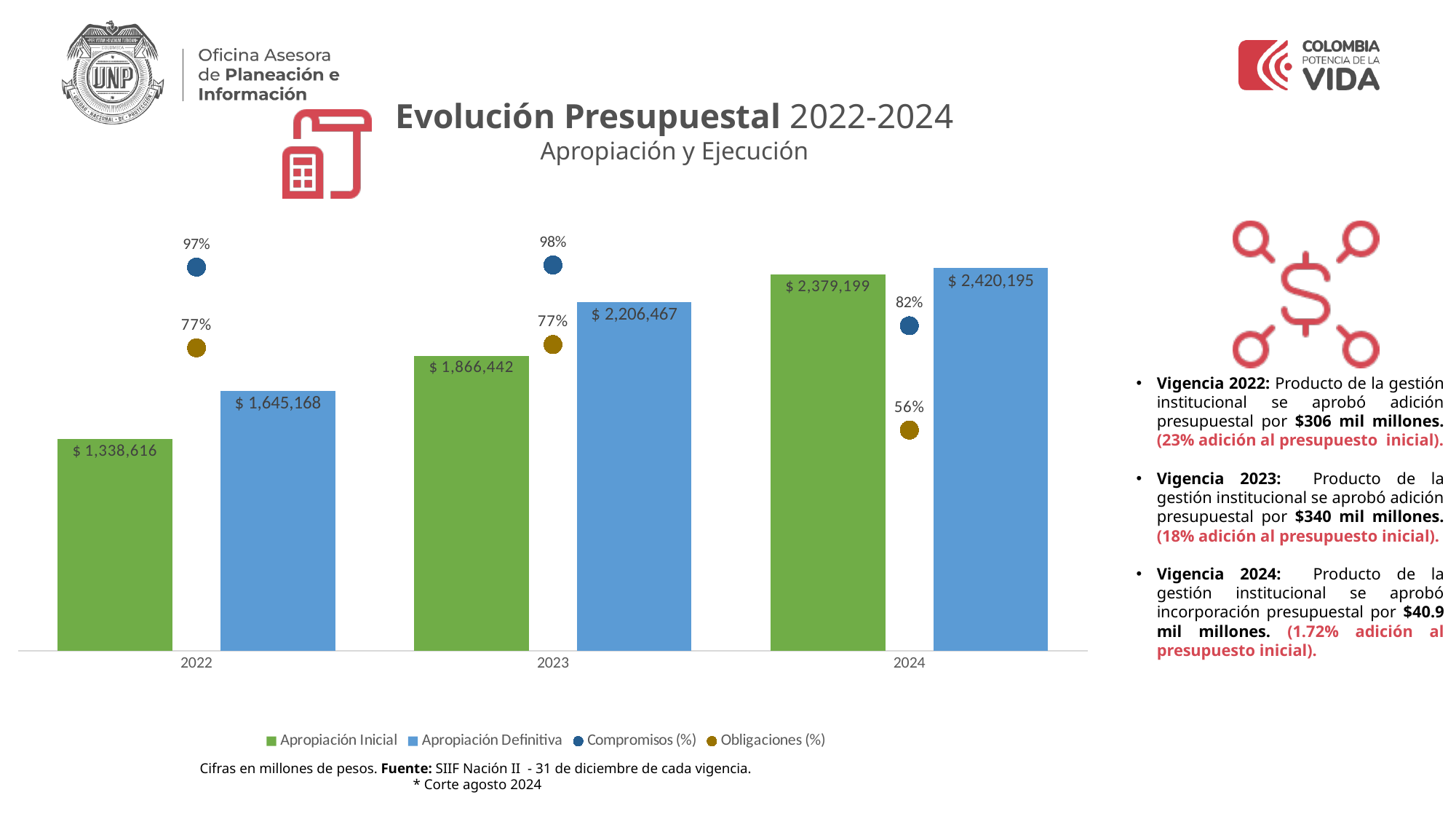
How many years are shown on the x axis of the chart? 3 Which year has the lowest Obligaciones (%)? 2024 Does the Apropiación Inicial rise or fall from 2022 to 2024? rise What is the difference between Apropiación Definitiva and Apropiación Inicial in 2023? $ 340,025 How many series does the chart legend list? 4 What is the Apropiación Inicial value for 2022? $ 1,338,616 Which year has the highest Apropiación Definitiva? 2024 Which is larger in 2024: Apropiación Inicial or Apropiación Definitiva? Apropiación Definitiva What is the Compromisos (%) value for 2024? 82% What is the Apropiación Definitiva value for 2023? $ 2,206,467 What is the Obligaciones (%) value for 2022? 77% What colour are the Apropiación Inicial bars in the chart? green